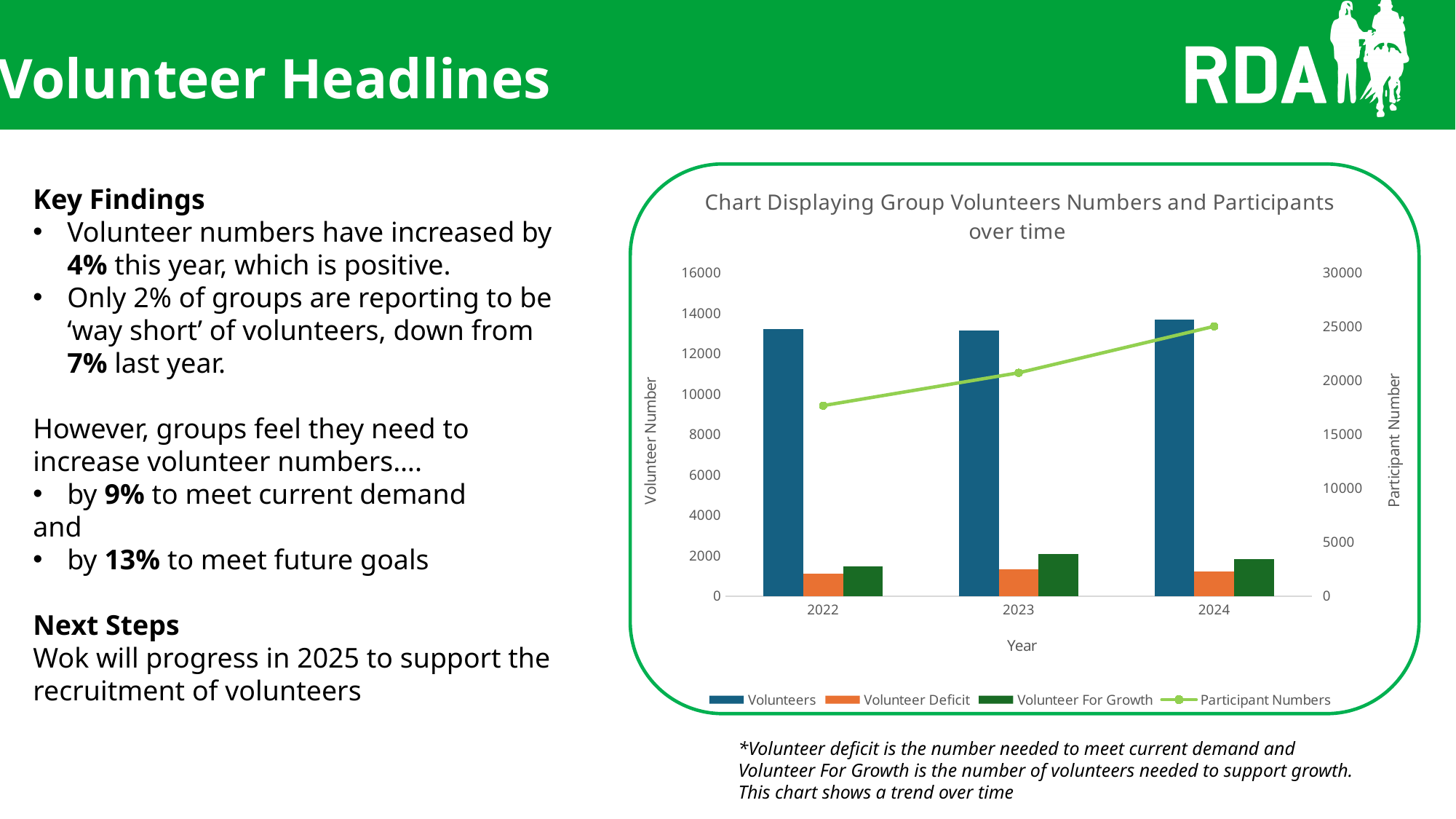
How many series does the chart legend list? 4 In which year is the Volunteer Deficit bar highest? 2023 In which year is the Volunteer For Growth bar highest? 2023 Is the Participant Numbers value for 2022 greater or less than 20000? less How many years are shown on the x axis of the chart? 3 In which year is the Volunteers bar highest? 2024 What is the title of the right-hand vertical axis of the chart? Participant Number Which is larger in 2022, the Volunteer Deficit bar or the Volunteer For Growth bar? Volunteer For Growth Is the Volunteers value for 2024 greater or less than 12000? greater Do Participant Numbers rise or fall from 2022 to 2024? Rise What kind of chart is shown on the slide? A combined bar and line chart Is the Participant Numbers value for 2024 greater or less than 20000? greater